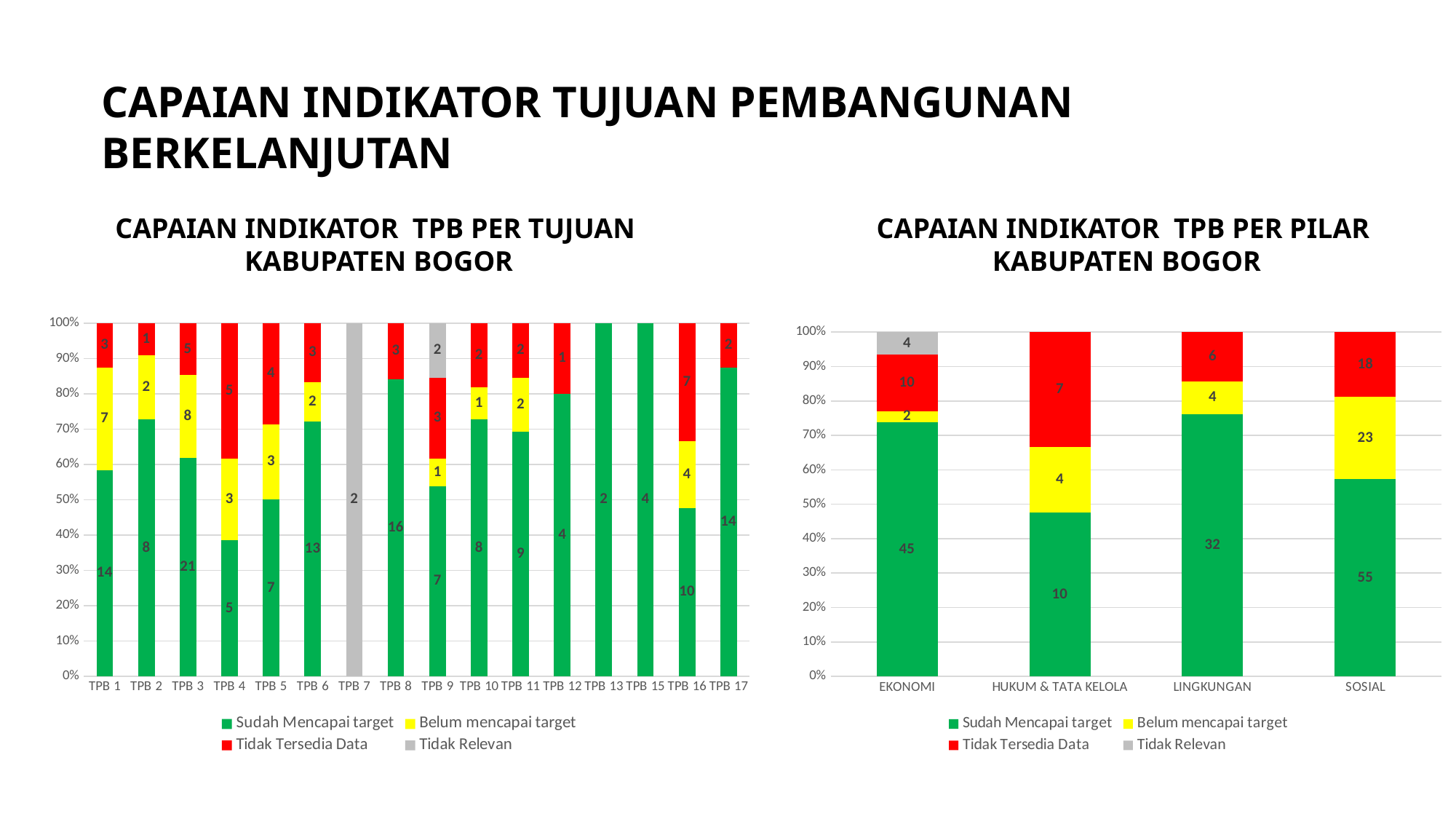
In the chart 'CAPAIAN INDIKATOR TPB PER TUJUAN KABUPATEN BOGOR', what is the value of 'Sudah Mencapai target' for TPB 3? 21 In the chart 'CAPAIAN INDIKATOR TPB PER PILAR KABUPATEN BOGOR', what is the value of 'Tidak Tersedia Data' for EKONOMI? 10 In the chart 'CAPAIAN INDIKATOR TPB PER TUJUAN KABUPATEN BOGOR', which TPB has the highest 'Tidak Tersedia Data' value? TPB 16 In the chart 'CAPAIAN INDIKATOR TPB PER TUJUAN KABUPATEN BOGOR', is the 'Sudah Mencapai target' share for TPB 4 greater or less than 40%? less In the chart 'CAPAIAN INDIKATOR TPB PER PILAR KABUPATEN BOGOR', what is the value of 'Sudah Mencapai target' for SOSIAL? 55 In the chart 'CAPAIAN INDIKATOR TPB PER PILAR KABUPATEN BOGOR', which pillar has the highest 'Belum mencapai target' value? SOSIAL How many series does the legend of the chart 'CAPAIAN INDIKATOR TPB PER PILAR KABUPATEN BOGOR' list? 4 In the chart 'CAPAIAN INDIKATOR TPB PER TUJUAN KABUPATEN BOGOR', what is the value of 'Tidak Relevan' for TPB 7? 2 How many categories are shown on the x axis of the chart 'CAPAIAN INDIKATOR TPB PER TUJUAN KABUPATEN BOGOR'? 16 In the chart 'CAPAIAN INDIKATOR TPB PER PILAR KABUPATEN BOGOR', what is the total of all labelled segments in the HUKUM & TATA KELOLA bar? 21 What kind of chart is 'CAPAIAN INDIKATOR TPB PER PILAR KABUPATEN BOGOR'? Stacked bar chart In the chart 'CAPAIAN INDIKATOR TPB PER PILAR KABUPATEN BOGOR', what is the difference between the 'Sudah Mencapai target' values for SOSIAL and EKONOMI? 10